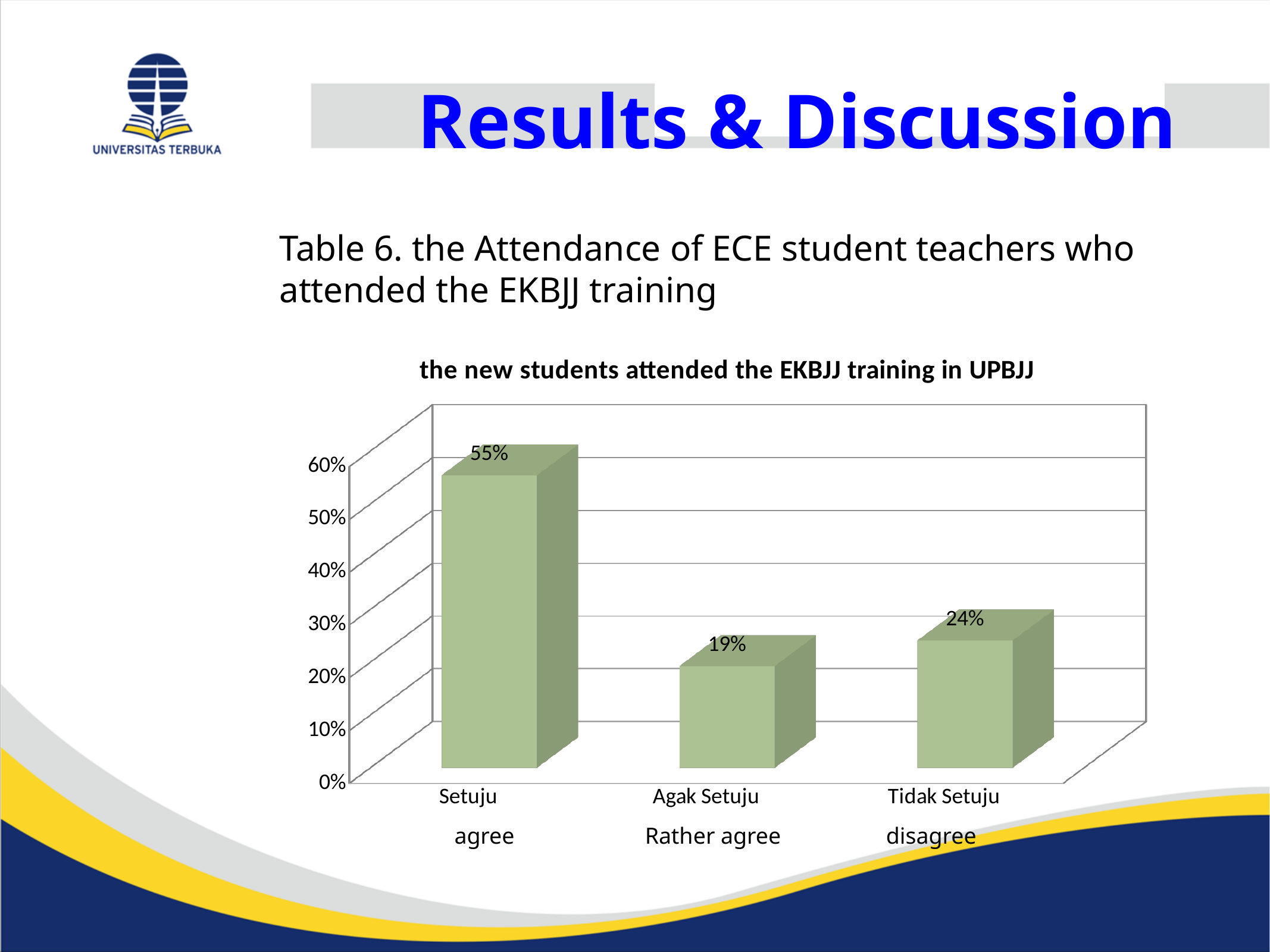
Is the value for Setuju greater or less than 50%? greater How many categories are shown on the x axis? 3 What is the difference between the values for Setuju and Tidak Setuju? 31% Which category has the highest value? Setuju What is the value for Tidak Setuju (disagree)? 24% Which is larger, the value for Agak Setuju or the value for Tidak Setuju? Tidak Setuju Which category has the lowest value? Agak Setuju What is the title of the chart? the new students attended the EKBJJ training in UPBJJ What kind of chart is shown on the slide? bar chart What is the value for Setuju (agree)? 55% What is the value for Agak Setuju (Rather agree)? 19% What is the difference between the values for Tidak Setuju and Agak Setuju? 5%